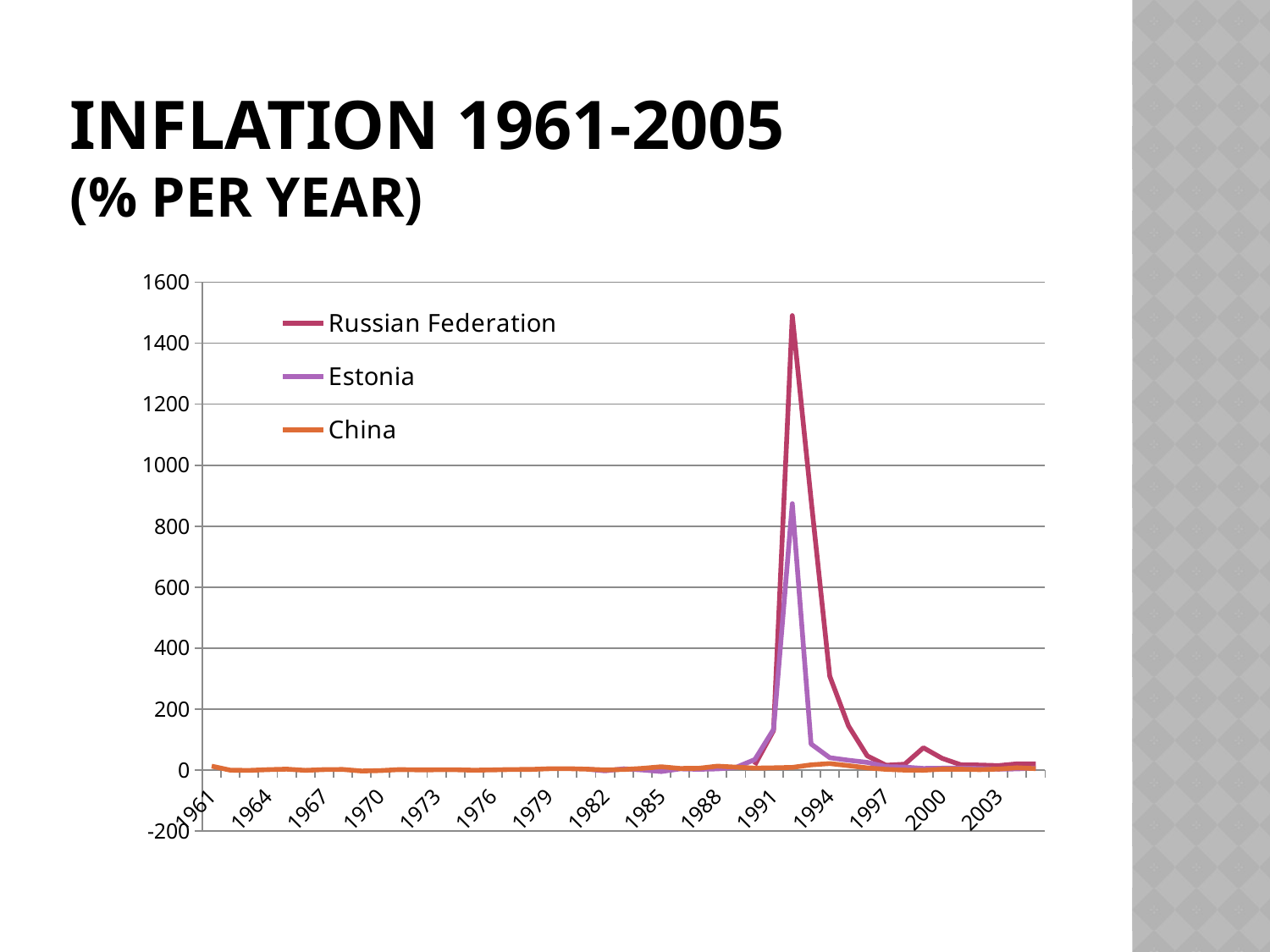
Which series has the lowest peak value? China What kind of chart is shown on the slide? line chart Is the peak value for Estonia greater or less than 1000? less What is the title of the chart on the slide? Inflation 1961-2005 (% per year) Which series reaches the highest peak value? Russian Federation Is the highest value for China greater or less than 200? less How many series does the legend list? 3 What is the highest value shown on the vertical axis? 1600 Is the peak value for the Russian Federation greater or less than 1400? greater Which series has the larger peak, Russian Federation or Estonia? Russian Federation Which series are listed in the legend? Russian Federation, Estonia, China